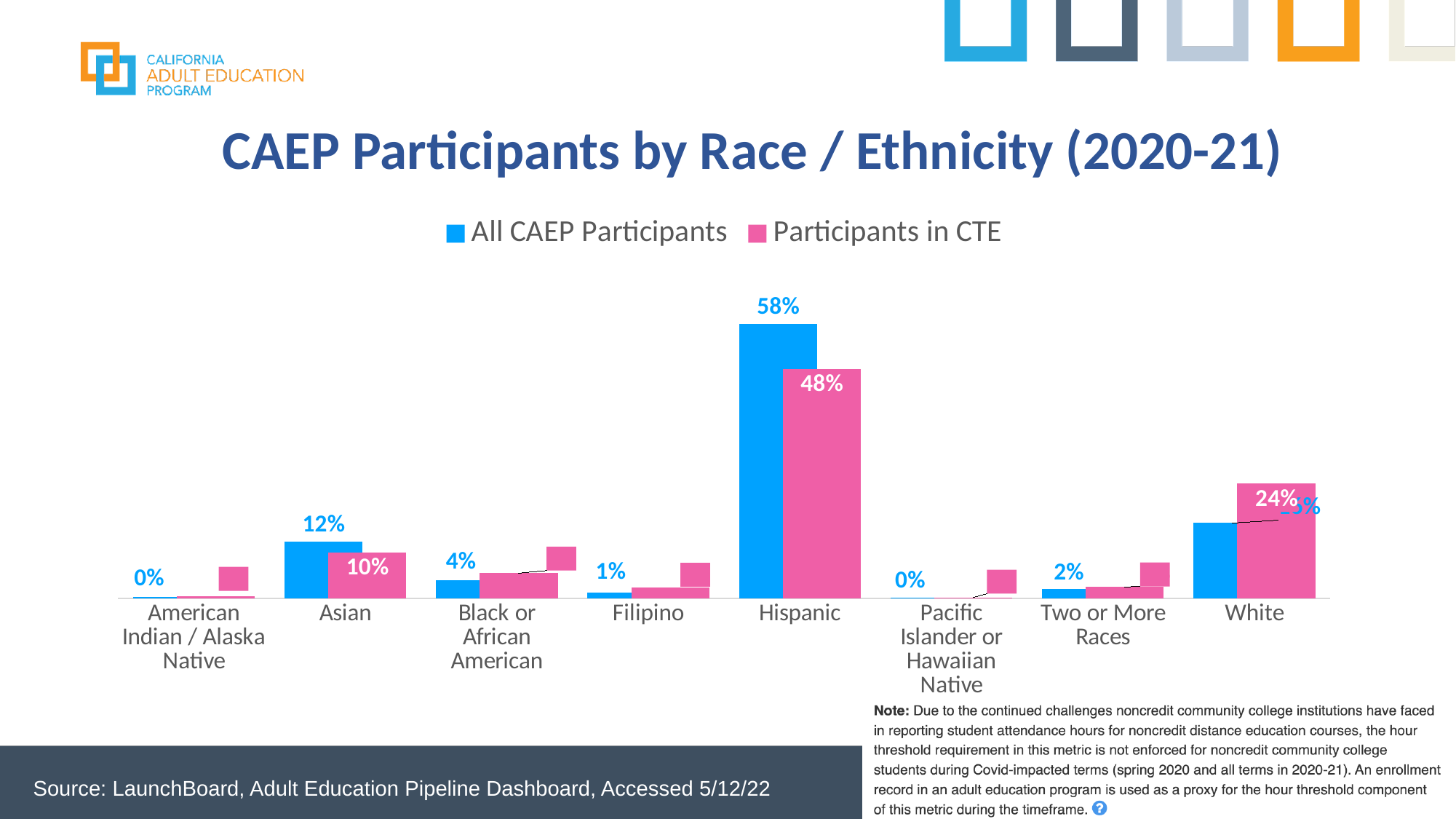
How many race/ethnicity categories are shown on the x axis? 8 What is the difference between the All CAEP Participants and Participants in CTE values for Hispanic? 10 percentage points What percentage of Participants in CTE are White? 24% What percentage of All CAEP Participants are Asian? 12% What percentage of Participants in CTE are Hispanic? 48% What kind of chart is shown on the slide? Bar chart For Asian, which is larger: the All CAEP Participants value or the Participants in CTE value? All CAEP Participants Which is larger among Participants in CTE: Hispanic or White? Hispanic How many series does the legend list? 2 Which race/ethnicity category has the highest share of All CAEP Participants? Hispanic What percentage of All CAEP Participants are Black or African American? 4% What percentage of All CAEP Participants are Hispanic? 58%